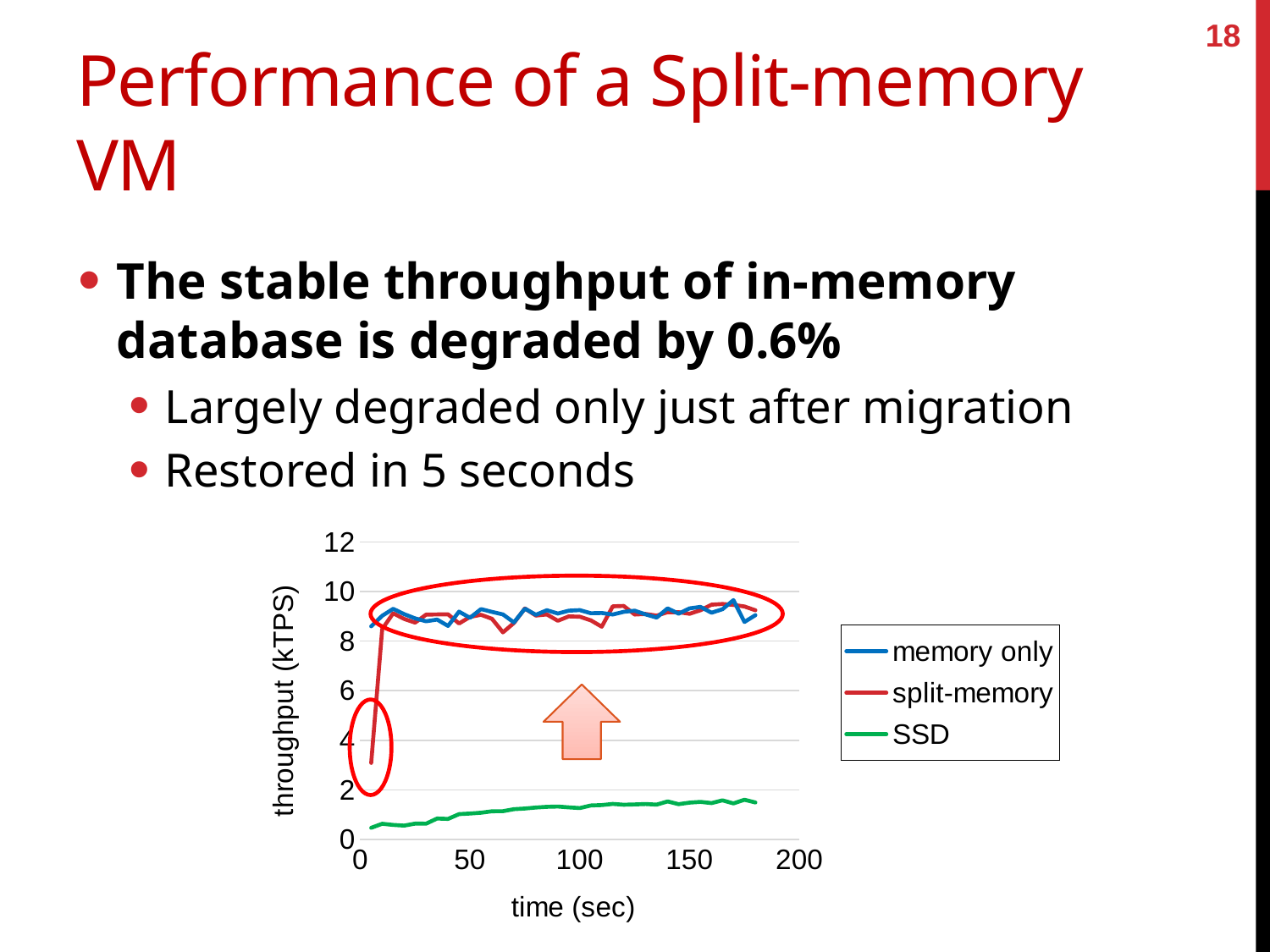
Is the throughput of the memory only series at 100 seconds greater or less than 8 kTPS? greater Does the throughput of the SSD series rise or fall as time increases? rise What are the three series named in the chart's legend? memory only, split-memory, SSD Which series has the lowest throughput throughout the chart? SSD Does the throughput of the split-memory series rise or fall between 0 and 10 seconds? rise Is the throughput of the SSD series at 100 seconds greater or less than 2 kTPS? less How many series does the chart's legend list? 3 Is the throughput of the split-memory series at its starting point (near 0 seconds) greater or less than 4 kTPS? less What is the label of the chart's y axis? throughput (kTPS) Which series has higher throughput at 150 seconds, SSD or memory only? memory only What kind of chart is shown on the slide? line chart